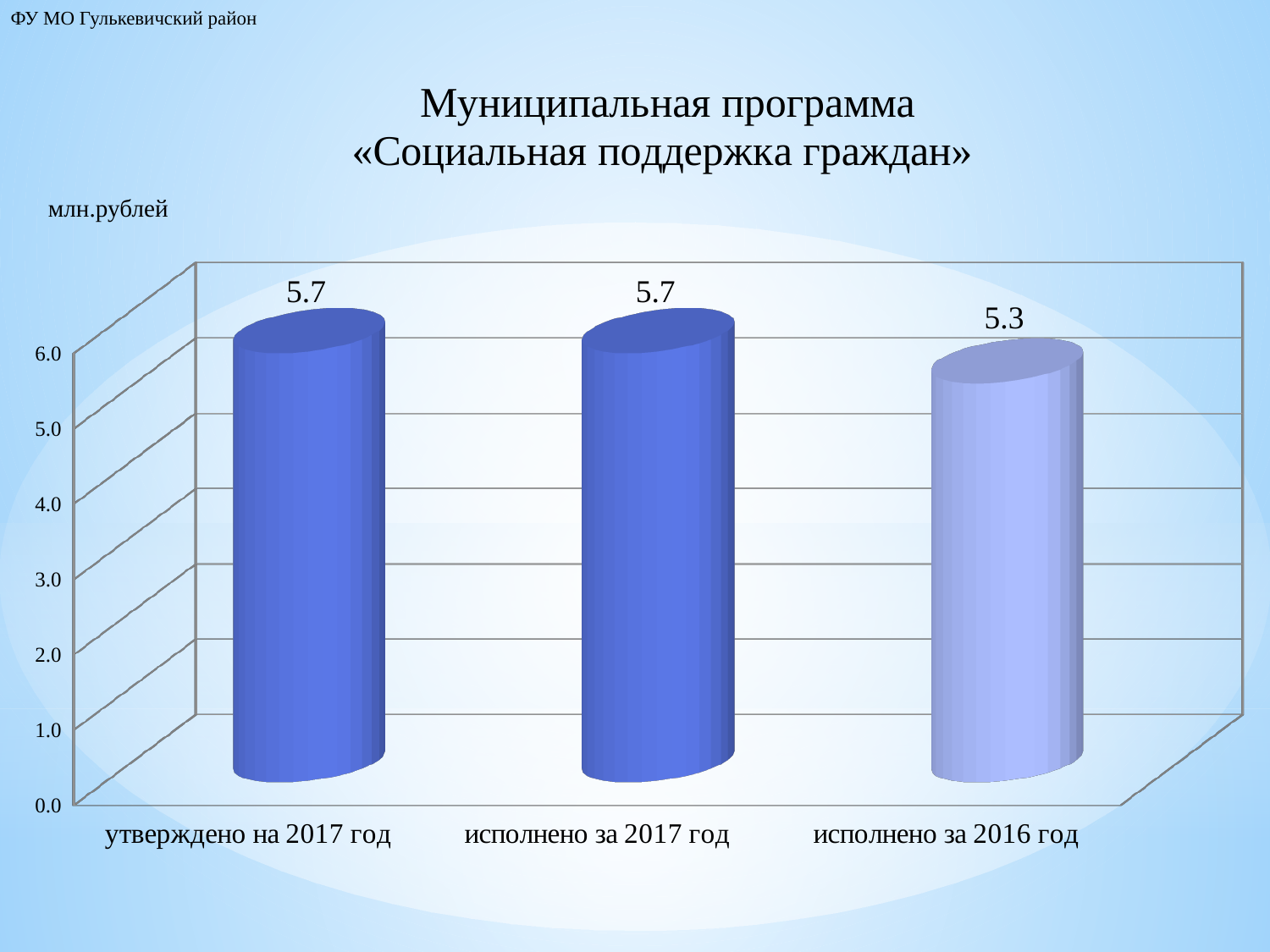
What is the title of the chart? Муниципальная программа «Социальная поддержка граждан» What is the difference between the value for «исполнено за 2017 год» and the value for «исполнено за 2016 год»? 0.4 Which category has the lowest value? исполнено за 2016 год Which is larger: the value for «утверждено на 2017 год» or the value for «исполнено за 2016 год»? утверждено на 2017 год What kind of chart is shown on the slide? bar chart What is the value for «утверждено на 2017 год»? 5.7 Is the value for «исполнено за 2017 год» greater or less than 6.0? less What is the value for «исполнено за 2016 год»? 5.3 Is the value for «исполнено за 2016 год» greater or less than 5.0? greater What unit of measurement is indicated for the chart values? млн.рублей What is the value for «исполнено за 2017 год»? 5.7 How many categories are shown on the chart? 3